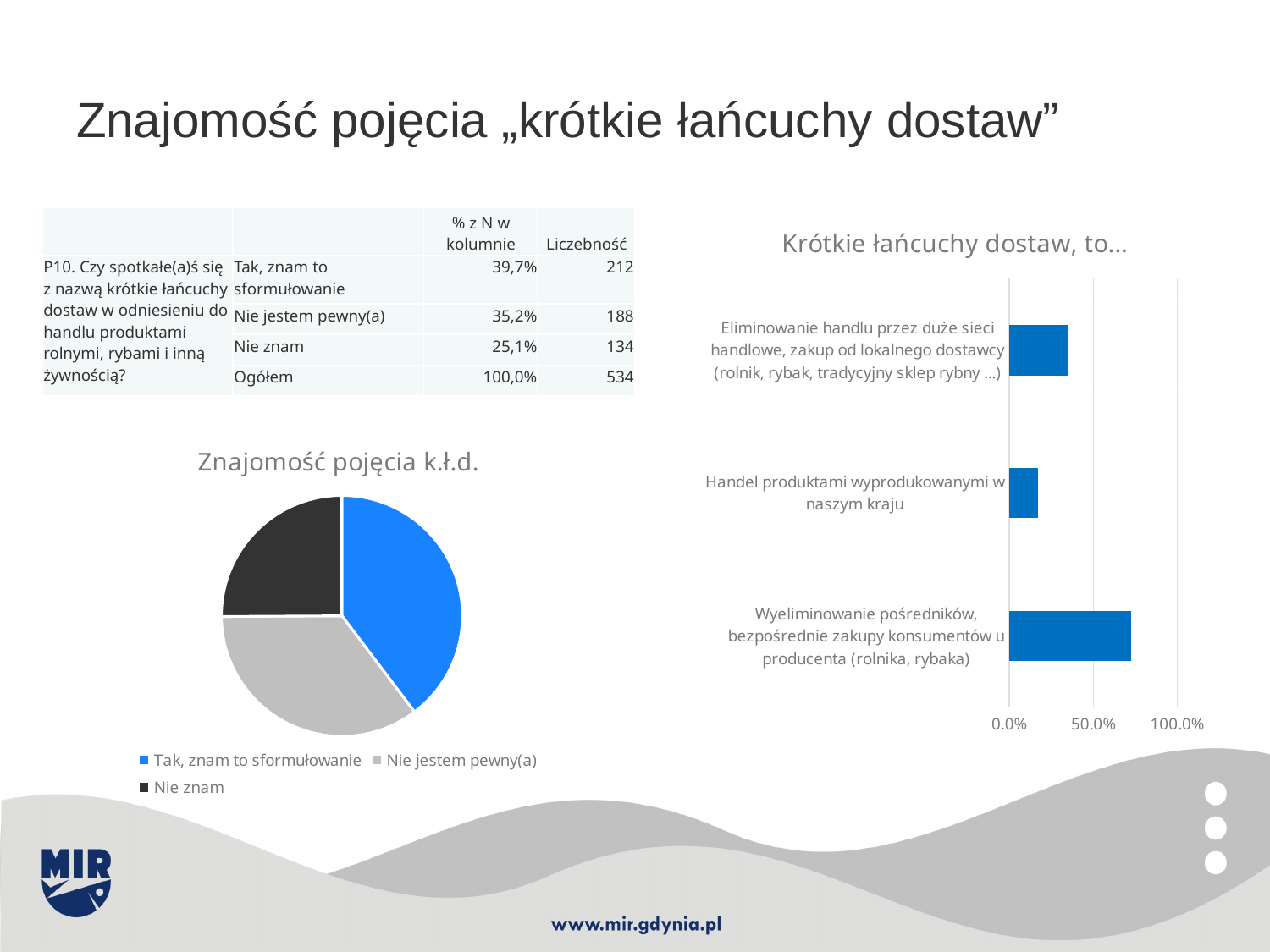
In the pie chart "Znajomość pojęcia k.ł.d.", what colour is the slice for "Nie jestem pewny(a)"? grey In the chart "Krótkie łańcuchy dostaw, to…", which category has the lowest value? Handel produktami wyprodukowanymi w naszym kraju What kind of chart is the chart titled "Znajomość pojęcia k.ł.d."? pie chart In the chart "Krótkie łańcuchy dostaw, to…", is the value for "Wyeliminowanie pośredników, bezpośrednie zakupy konsumentów u producenta (rolnika, rybaka)" greater or less than 50.0%? greater In the pie chart "Znajomość pojęcia k.ł.d.", which slice is the smallest? Nie znam How many entries does the legend of the pie chart "Znajomość pojęcia k.ł.d." list? 3 In the chart "Krótkie łańcuchy dostaw, to…", how many categories are plotted? 3 In the chart "Krótkie łańcuchy dostaw, to…", is the value for "Handel produktami wyprodukowanymi w naszym kraju" greater or less than 50.0%? less In the pie chart "Znajomość pojęcia k.ł.d.", which slice is the largest? Tak, znam to sformułowanie What kind of chart is the chart titled "Krótkie łańcuchy dostaw, to…"? bar chart In the chart "Krótkie łańcuchy dostaw, to…", which is larger: the value for "Eliminowanie handlu przez duże sieci handlowe..." or for "Handel produktami wyprodukowanymi w naszym kraju"? Eliminowanie handlu przez duże sieci handlowe... In the chart "Krótkie łańcuchy dostaw, to…", which category has the highest value? Wyeliminowanie pośredników, bezpośrednie zakupy konsumentów u producenta (rolnika, rybaka)